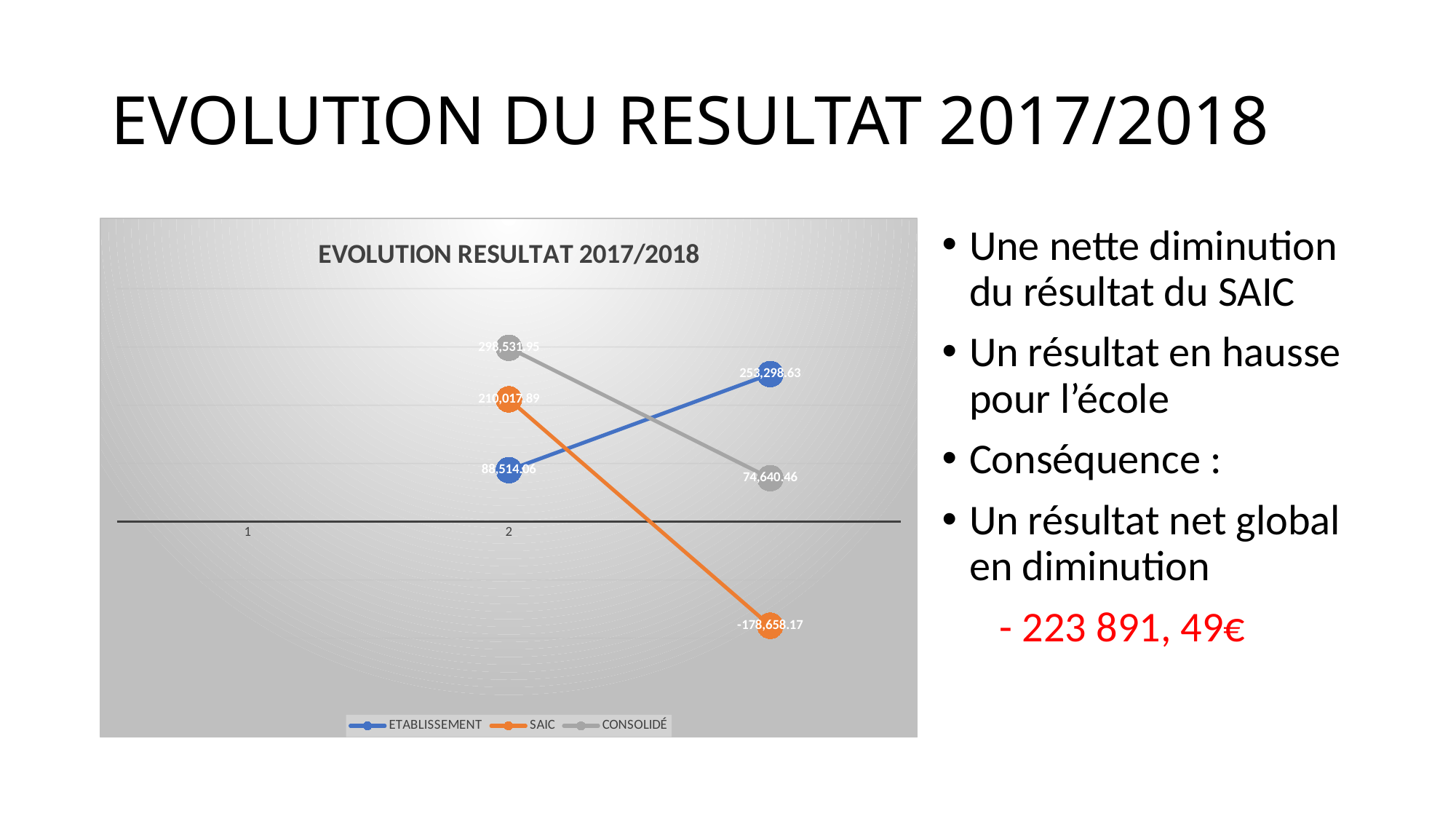
Which series has the lowest value at its final (right-hand) point? SAIC By how much does the CONSOLIDÉ series decrease from its first point (298,531.95) to its second point (74,640.46)? 223,891.49 Does the ETABLISSEMENT series rise or fall from its first point to its second point? rise What is the final (right-hand) value of the ETABLISSEMENT series? 253,298.63 Does the SAIC series rise or fall from its first point to its second point? fall What is the title of the chart? EVOLUTION RESULTAT 2017/2018 How many series does the chart legend list? 3 What is the final (right-hand) value of the SAIC series? -178,658.17 What type of chart is shown on the slide? line chart What is the starting (left-hand) value of the ETABLISSEMENT series? 88,514.06 Which series has the highest value at its final (right-hand) point? ETABLISSEMENT What is the starting (left-hand) value of the CONSOLIDÉ series? 298,531.95